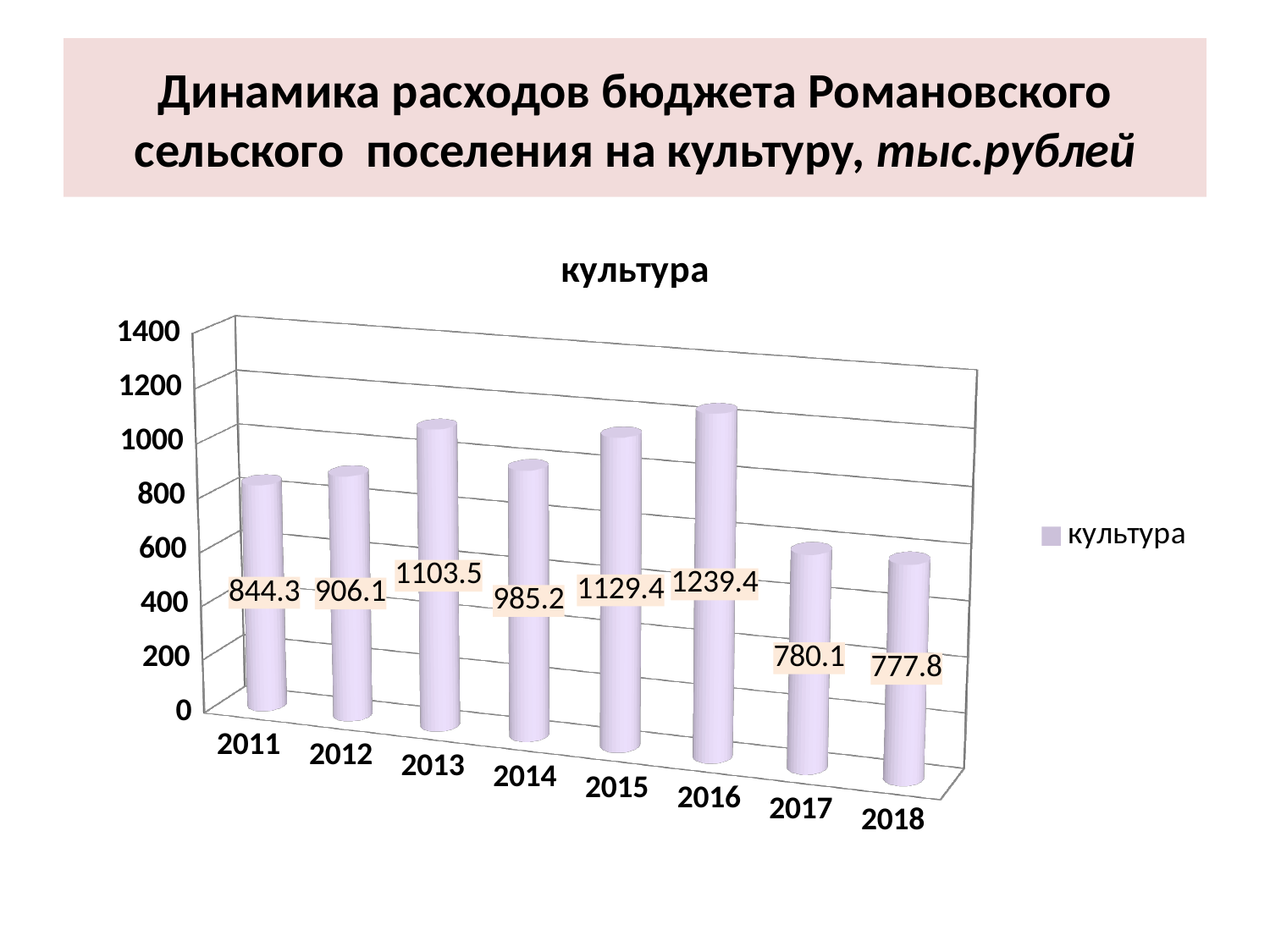
Which year has the lowest value? 2018 What is the title of the chart? культура What kind of chart is this? bar chart Which year has the highest value? 2016 How many years are shown on the chart? 8 Is the value for 2015 greater or less than 1000? greater What is the difference between the values for 2016 and 2017? 459.3 Which is larger, the value for 2013 or the value for 2014? 2013 What is the value for 2016? 1239.4 What is the value for 2011? 844.3 What is the value for 2018? 777.8 What is the difference between the values for 2013 and 2012? 197.4